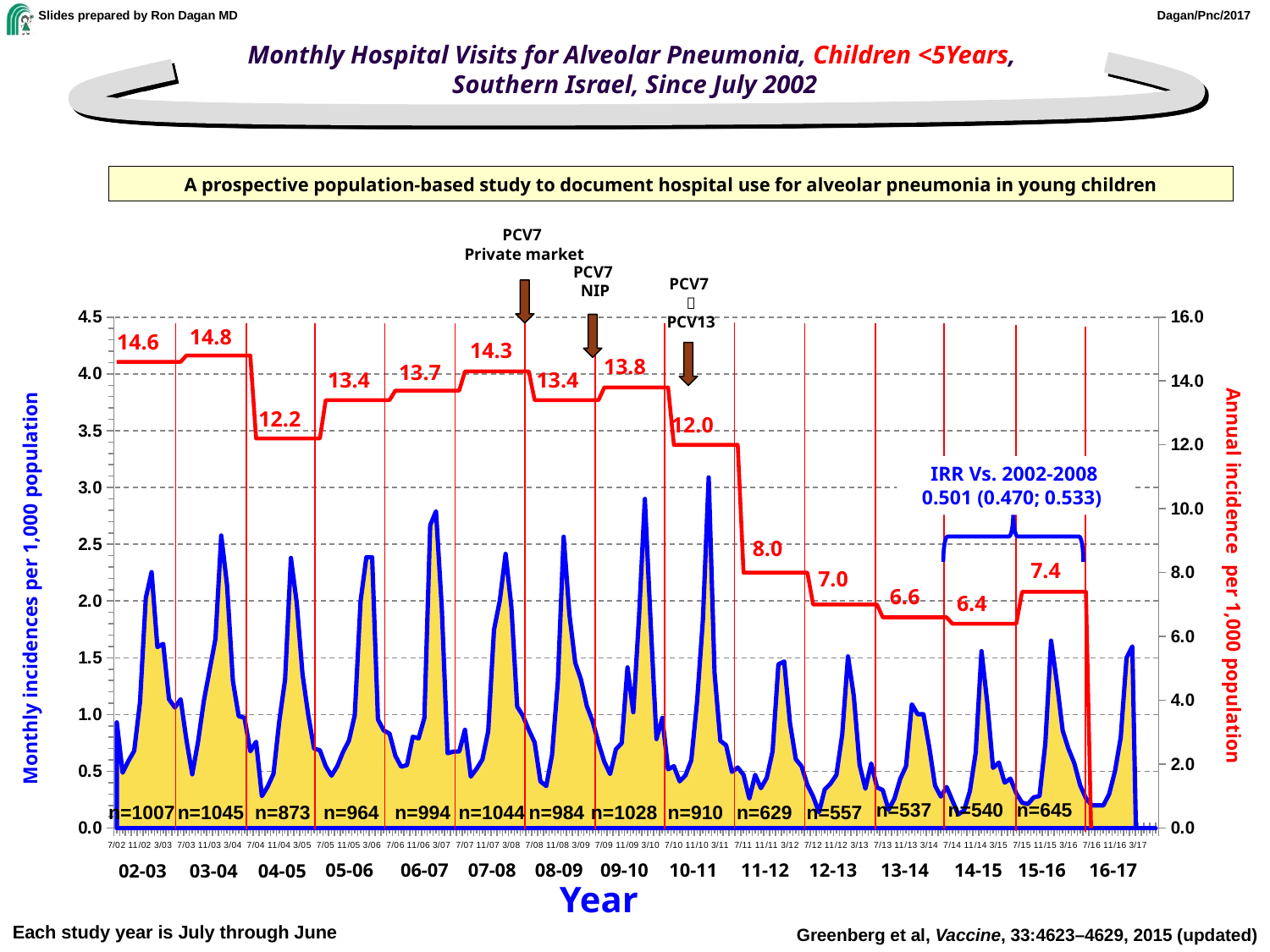
Is the peak monthly incidence in the 11-12 study year greater or less than 2.0 per 1,000 population? less Does the annual incidence (red line) generally rise or fall from 2002 to 2016? fall Which study year has the higher annual incidence, 07-08 or 08-09? 07-08 Which study year has the highest annual incidence per 1,000 population? 03-04 How many study years are labelled along the x axis? 15 What is the difference in annual incidence between the 11-12 and 12-13 study years? 1.0 What kind of chart is used to show the monthly incidences? area chart What is the annual incidence per 1,000 population shown for the 02-03 study year? 14.6 What is the difference between the highest annual incidence (03-04) and the lowest annual incidence (14-15)? 8.4 What is the annual incidence per 1,000 population shown for the 14-15 study year? 6.4 Which study year has the lowest annual incidence per 1,000 population? 14-15 What is the number of cases (n) shown for the 07-08 study year? n=1044